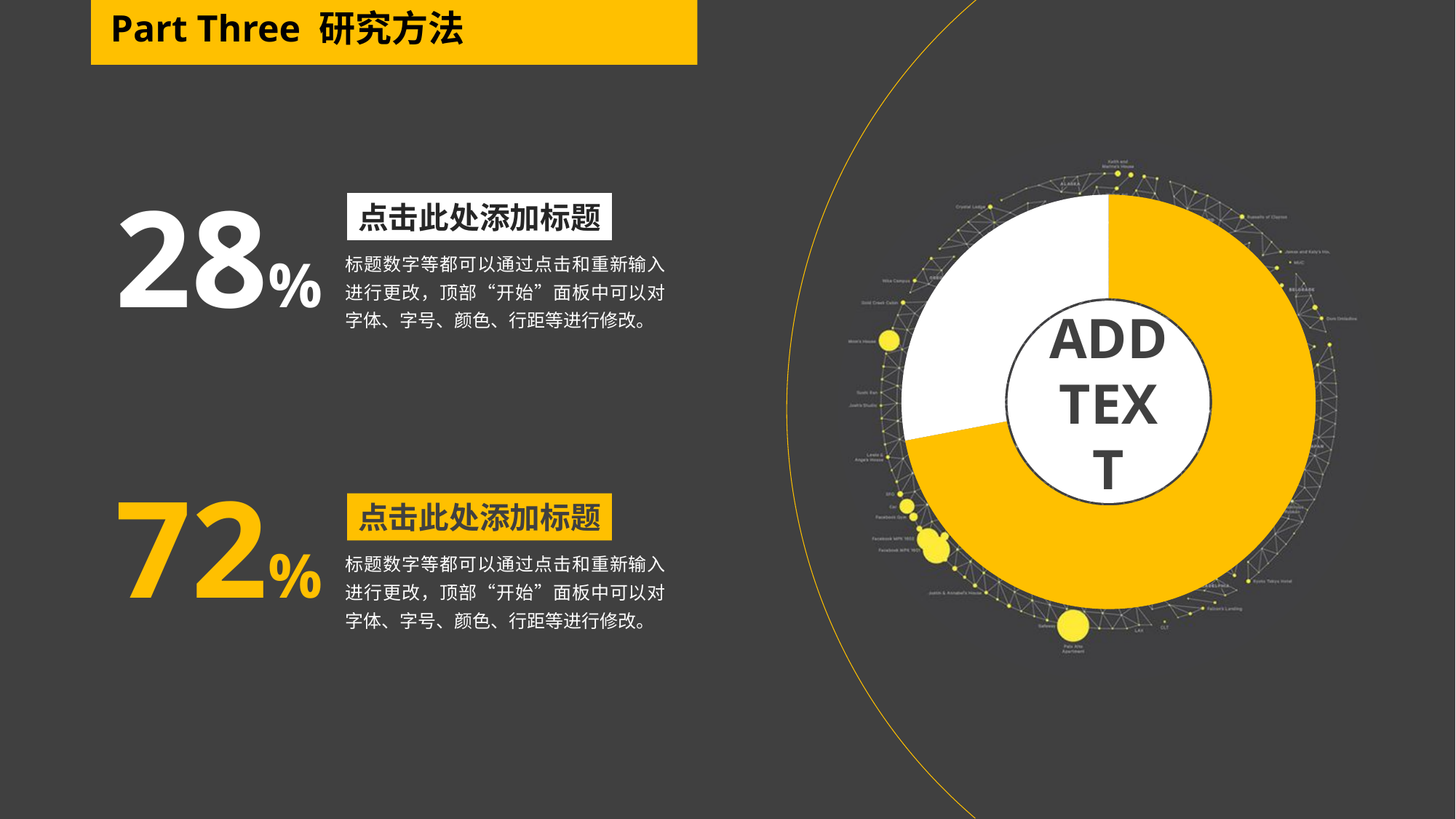
What percentage is shown in yellow on the left of the slide, matching the yellow slice of the donut chart? 72% Which slice of the donut chart is the smallest? the white slice How many slices does the donut chart on the right have? 2 What percentage is shown in white on the left of the slide, matching the white slice of the donut chart? 28% What two colours are used for the slices of the donut chart? yellow and white What is the difference between the two percentages shown on the slide, 72% and 28%? 44% What kind of chart is shown on the right side of the slide? pie chart (donut) Which slice of the donut chart is the largest? the yellow slice Is the yellow slice of the donut chart greater or less than half of the chart? greater What text is written in the centre of the donut chart? ADD TEXT Which slice of the donut chart is larger, the yellow one or the white one? yellow